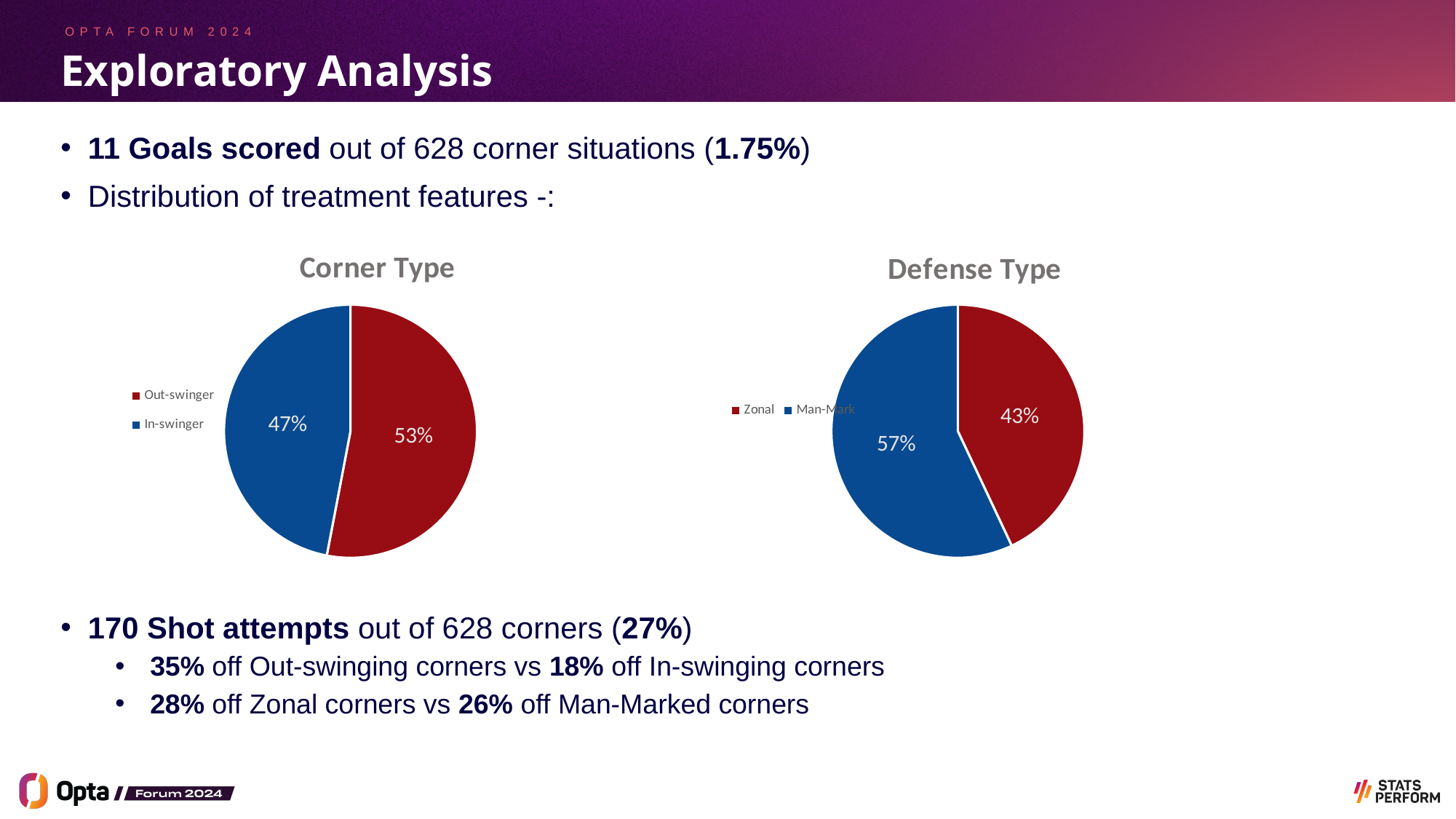
In the Defense Type chart, what is the difference between the Man-Mark and Zonal shares? 14% In the Defense Type chart, what share is Zonal? 43% In the Corner Type chart, which category has the larger share? Out-swinger In the Defense Type chart, what share is Man-Mark? 57% In the Defense Type chart, which is larger, Zonal or Man-Mark? Man-Mark In the Corner Type chart, what is the difference between the Out-swinger and In-swinger shares? 6% In the Corner Type chart, what share of corners are Out-swinger? 53% In the Defense Type chart, which category has the smaller share? Zonal What kind of chart is the Corner Type chart? Pie chart In the Corner Type chart, what colour is the In-swinger slice? Blue How many categories does the Defense Type chart show? 2